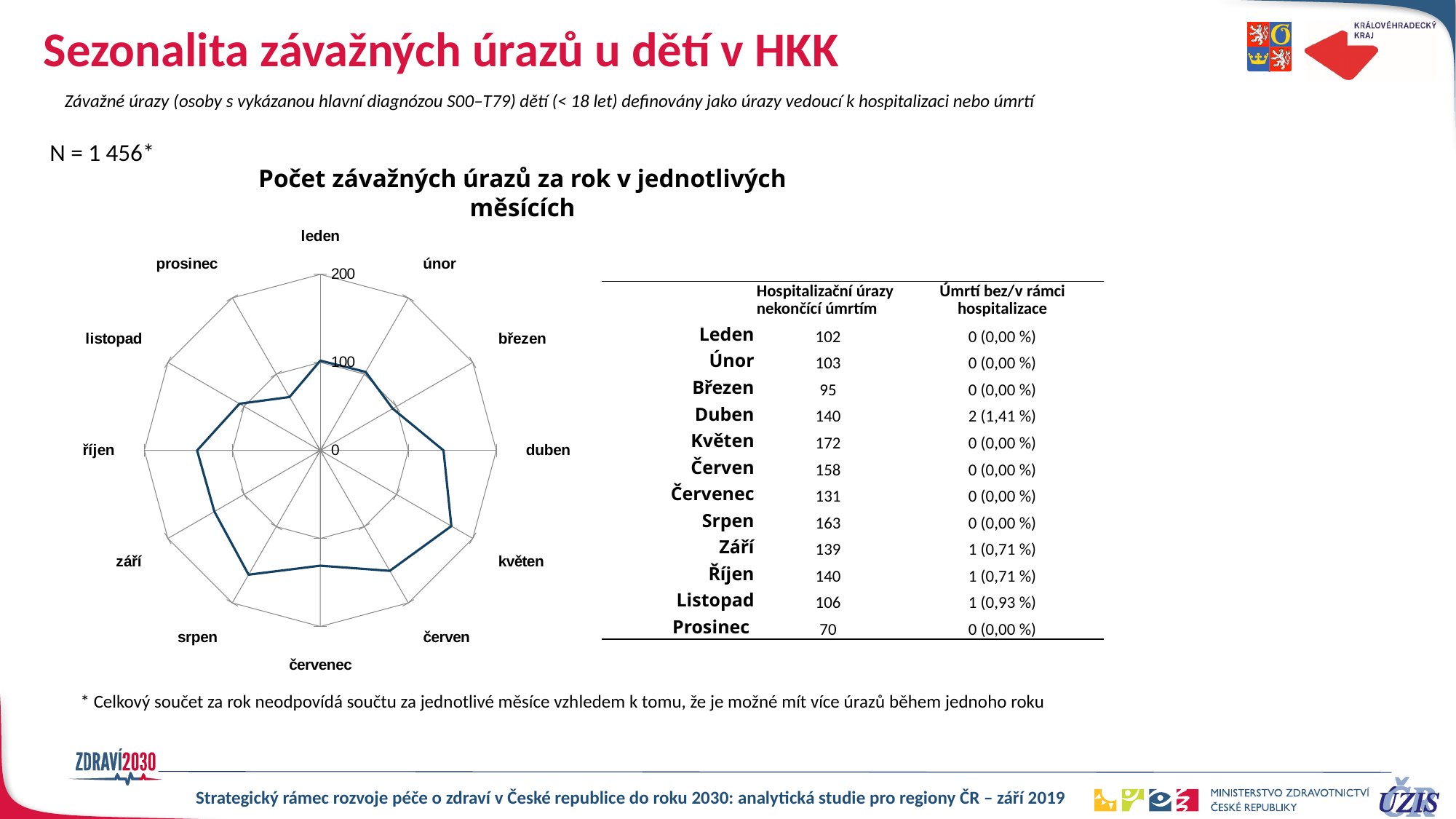
What kind of chart is shown on the slide? radar chart How many categories (months) does the radar chart have? 12 What is the highest value shown on the chart's axis? 200 Which month has the lowest value on the radar chart? prosinec Is the value for srpen greater or less than 100? greater Which has the larger value on the chart, květen or prosinec? květen Is the value for květen greater or less than 100? greater What is the title of the chart? Počet závažných úrazů za rok v jednotlivých měsících Which has the larger value on the chart, duben or únor? duben Is the value for prosinec greater or less than 100? less Which has the larger value on the chart, srpen or leden? srpen